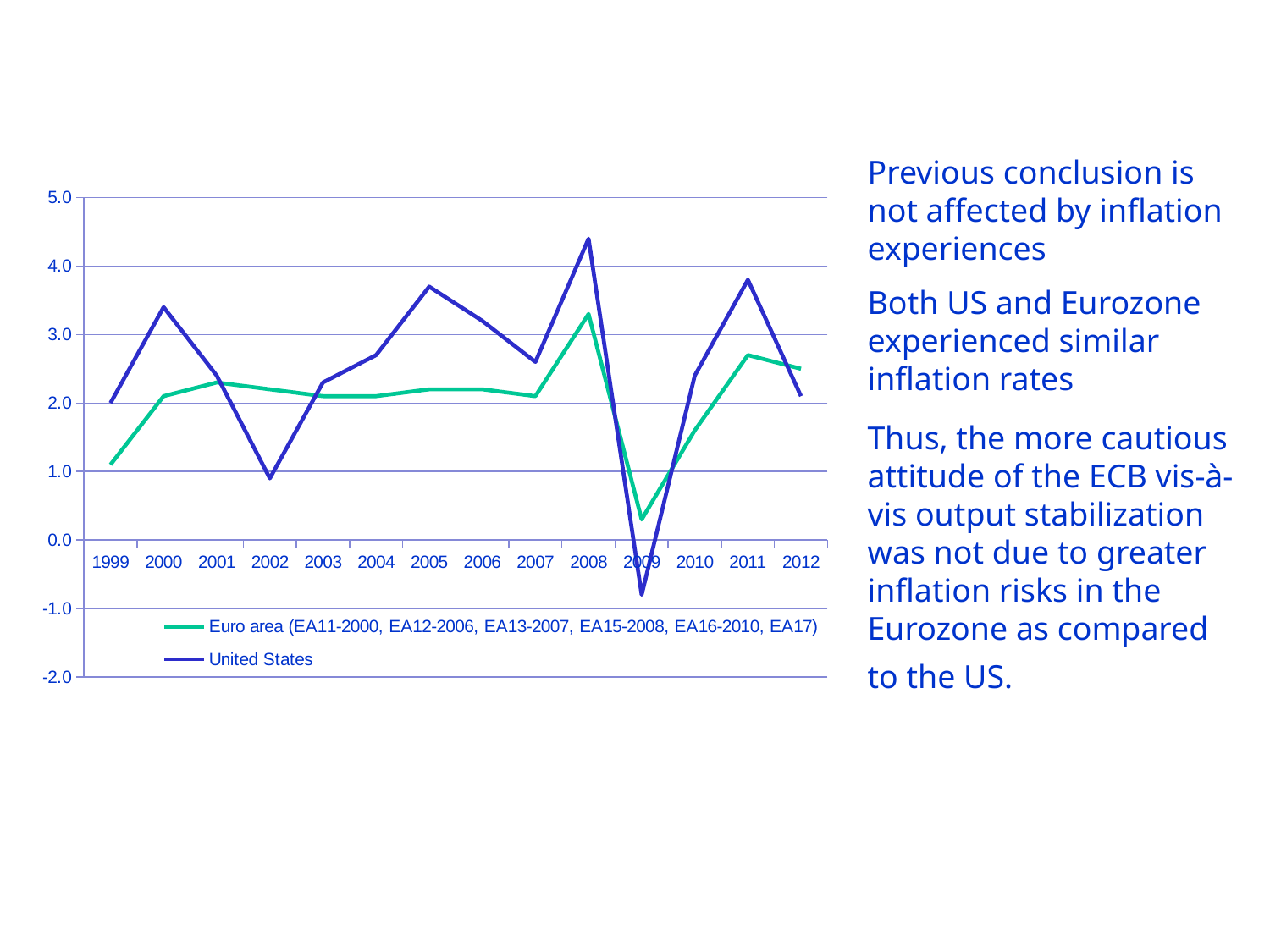
Is the Euro area value for 1999 greater or less than 2.0? less How many series does the legend list? 2 What kind of chart is shown on the slide? line chart Which series has the higher value in 2002, Euro area or United States? Euro area How many years are plotted along the x axis? 14 In which year does the United States line reach its highest value? 2008 Which series has the higher value in 2000, Euro area or United States? United States Is the United States value for 2009 greater or less than 0.0? less Does the United States line rise or fall from 2009 to 2011? rise In which year does the United States line reach its lowest value? 2009 In which year does the Euro area line reach its lowest value? 2009 Is the United States value for 2008 greater or less than 4.0? greater